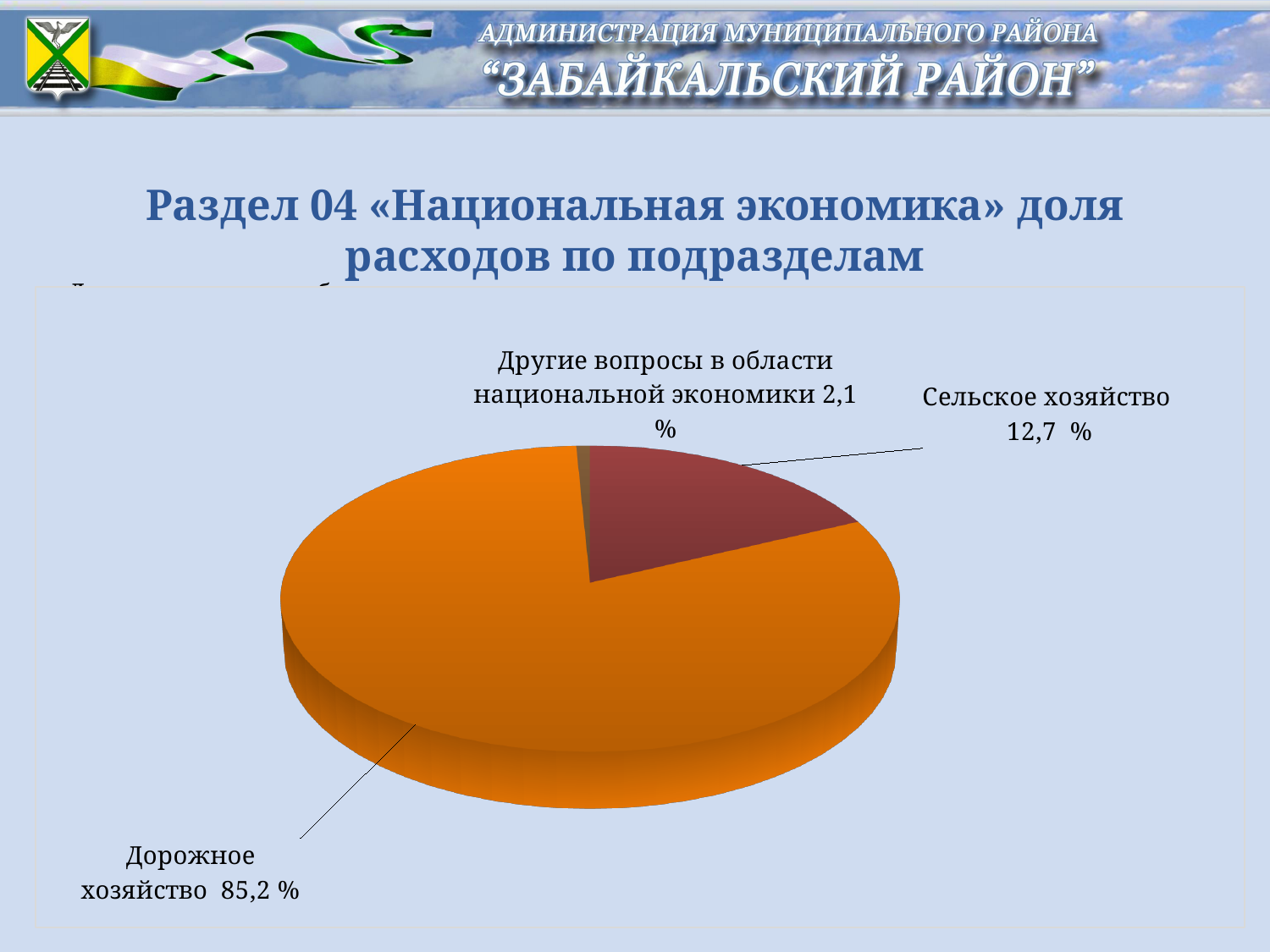
What share of expenditure does Дорожное хозяйство account for? 85,2 % Which subsection has the largest share of expenditure? Дорожное хозяйство How many slices does the pie chart have? 3 What is the title of the chart on the slide? Раздел 04 «Национальная экономика» доля расходов по подразделам Which subsection has the smallest share of expenditure? Другие вопросы в области национальной экономики What is the difference in percentage points between Сельское хозяйство and Другие вопросы в области национальной экономики? 10,6 Which is larger: the share of Сельское хозяйство or the share of Другие вопросы в области национальной экономики? Сельское хозяйство What share is shown for Другие вопросы в области национальной экономики? 2,1 % What share of expenditure does Сельское хозяйство account for? 12,7 % What is the difference in percentage points between Дорожное хозяйство and Сельское хозяйство? 72,5 What colour is the slice for Сельское хозяйство? Dark red What kind of chart is shown on the slide? Pie chart